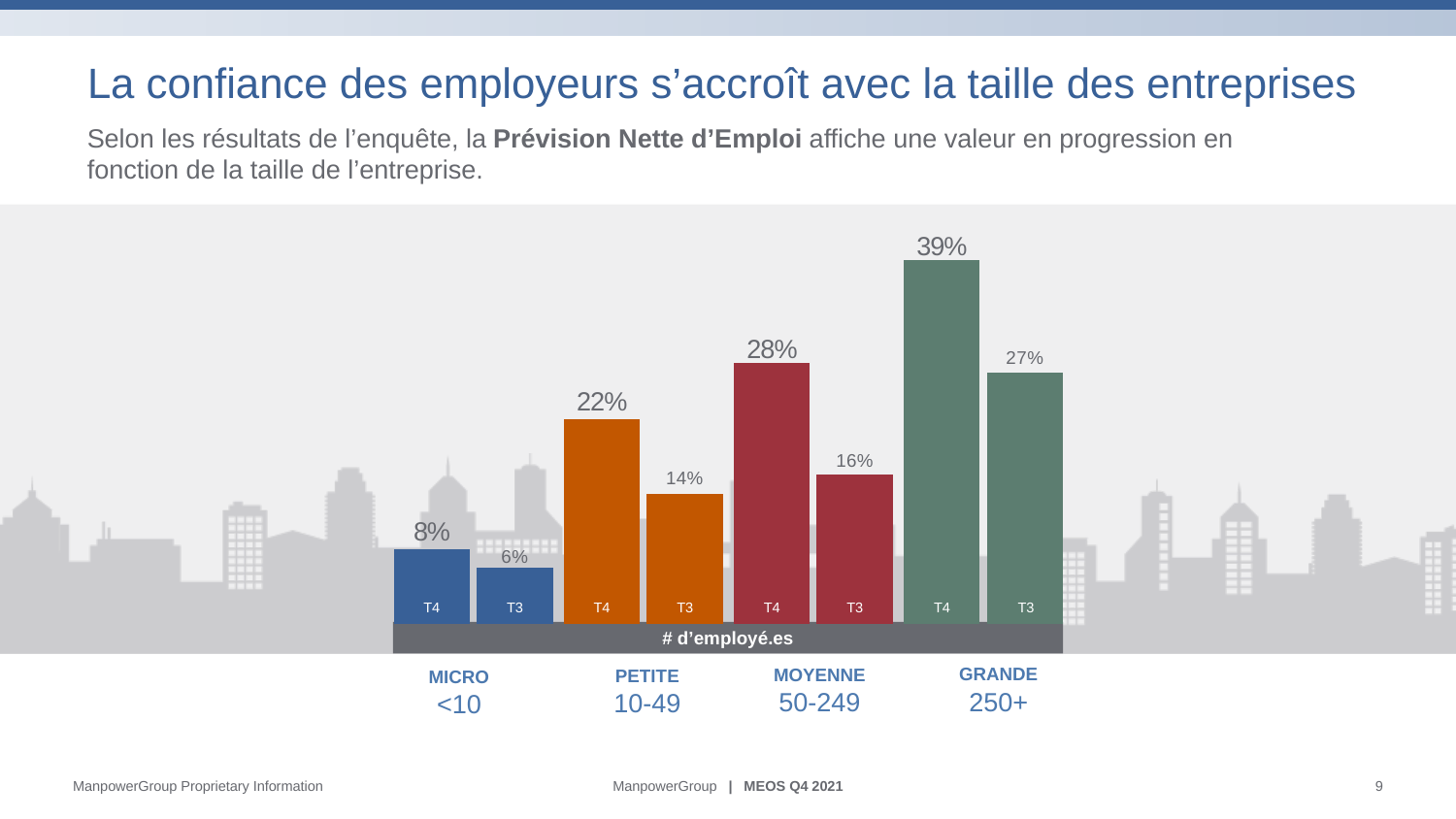
What is the T4 value for the MICRO (<10) category? 8% What kind of chart is shown on the slide? Bar chart Which is larger: the T3 value for GRANDE or the T4 value for MOYENNE? T4 value for MOYENNE How many company size categories are shown in the chart? 4 Do the T4 values rise or fall as company size increases from MICRO to GRANDE? Rise What is the difference between the T4 and T3 values for the GRANDE category? 12% What is the difference between the T4 values for MOYENNE and PETITE? 6% Which company size category has the lowest T3 value? MICRO Which company size category has the highest T4 value? GRANDE What is the T3 value for the MOYENNE (50-249) category? 16% What is the T3 value for the PETITE (10-49) category? 14% What is the T4 value for the GRANDE (250+) category? 39%